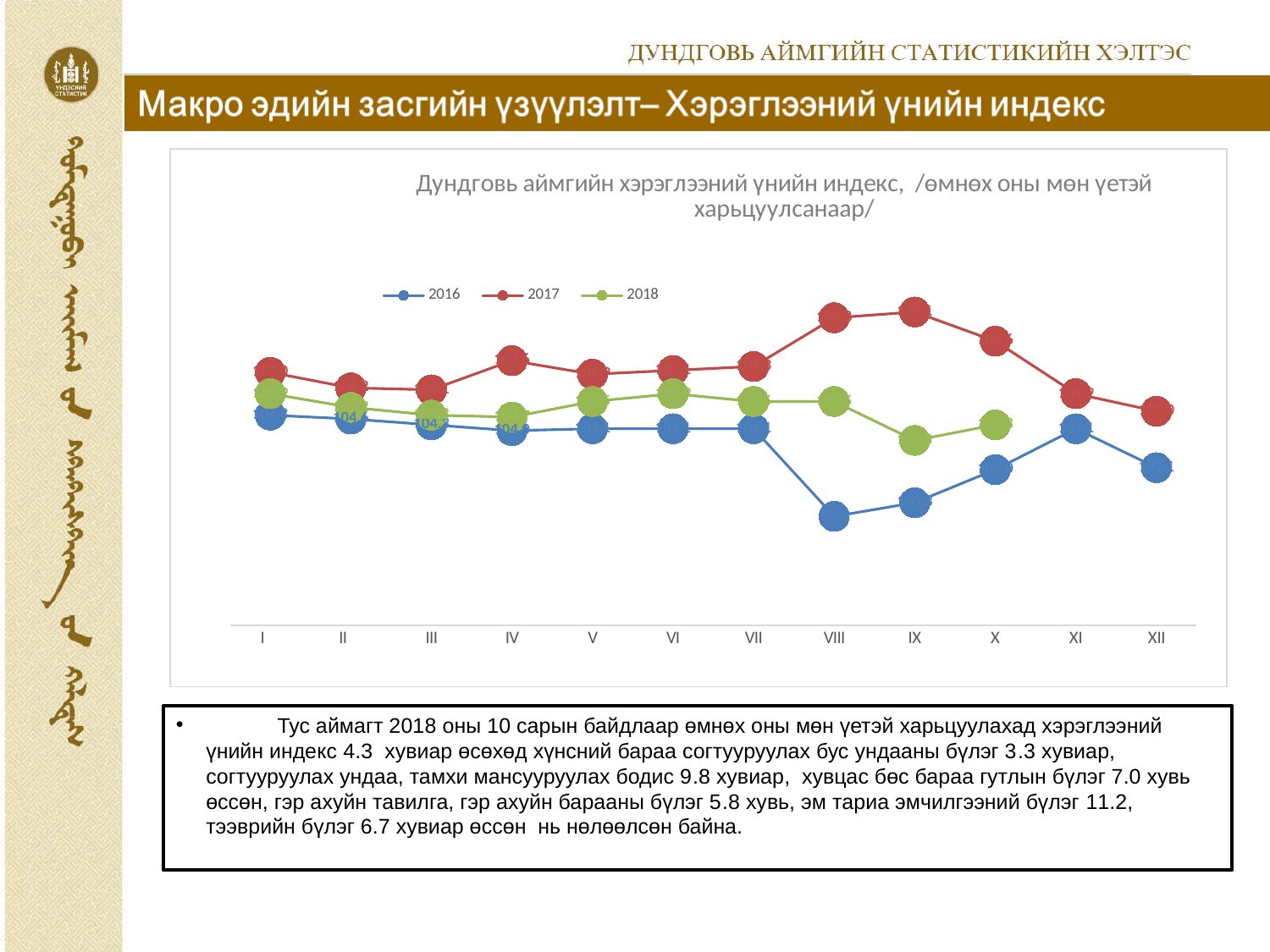
In month VIII, which series has the higher value, 2016 or 2017? 2017 How many months are shown on the x axis? 12 How many data points does the 2018 series have? 10 In which month does the 2017 series reach its lowest value? XII What kind of chart is shown on the slide? line chart In which month does the 2018 series reach its lowest value? IX Does the 2017 series rise or fall from month IX to month XII? fall How many series does the legend list? 3 Which years are listed in the chart legend? 2016, 2017, 2018 In which month does the 2016 series reach its lowest value? VIII In month X, which series has the higher value, 2016 or 2018? 2018 Does the 2016 series rise or fall from month VIII to month XI? rise